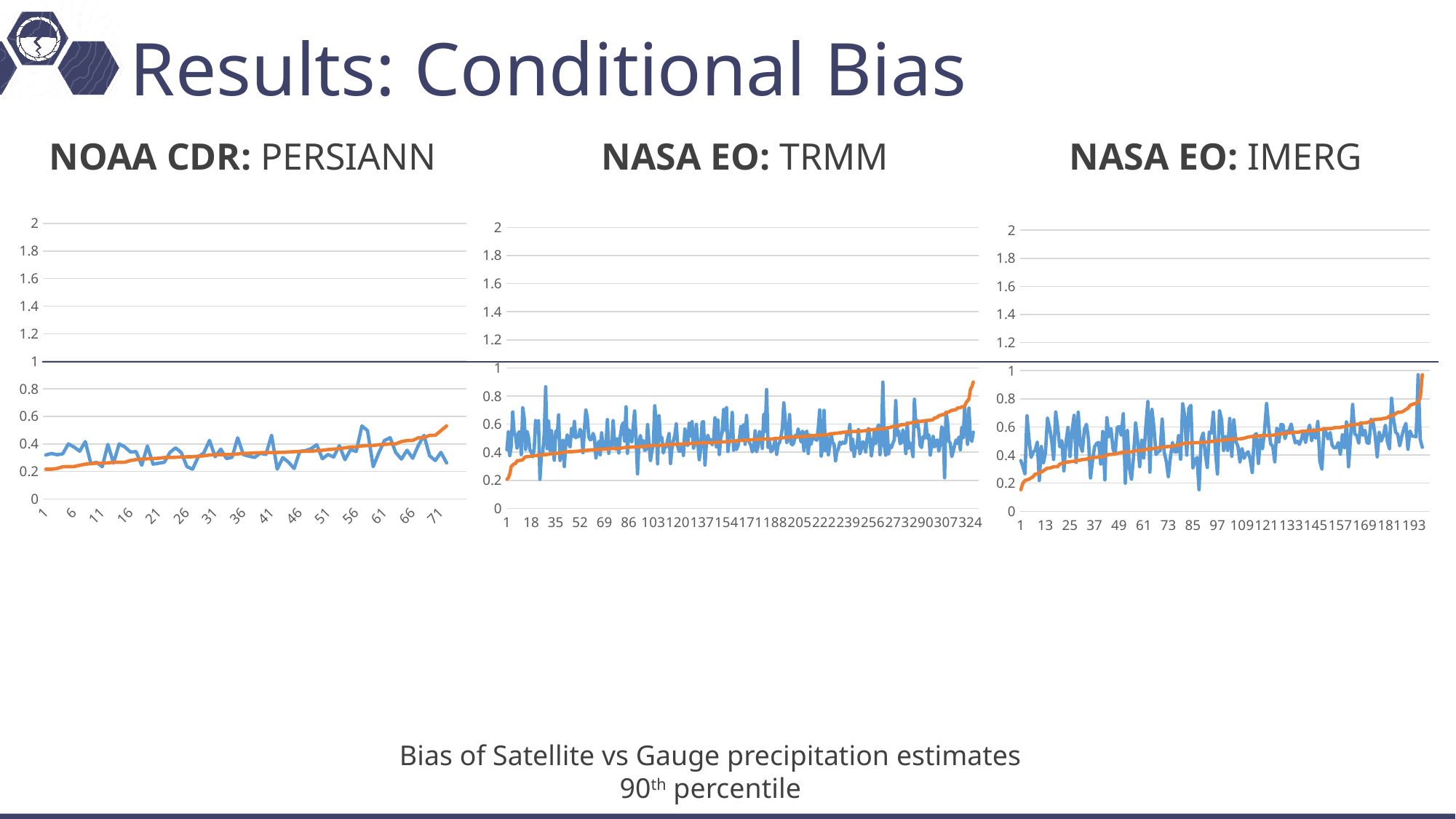
In the NOAA CDR: PERSIANN chart, is the orange line's value larger at x = 71 or at x = 1? x = 71 In the NASA EO: IMERG chart, is the value of the orange line at x = 1 greater or less than 0.4? less What is the highest tick value shown on the y axis of the NASA EO: TRMM chart? 2 What is the last x-axis label shown on the NASA EO: TRMM chart? 324 In the NASA EO: TRMM chart, does the orange line rise or fall along the x axis? rise What is the last x-axis label shown on the NASA EO: IMERG chart? 193 In the NOAA CDR: PERSIANN chart, is the value of the orange line at x = 1 greater or less than 0.4? less In the NASA EO: TRMM chart, is the highest value of the blue line greater or less than 1? less What kind of chart is the NOAA CDR: PERSIANN chart? line chart How many charts are shown on the slide? 3 In the NASA EO: IMERG chart, does the orange line rise or fall along the x axis? rise